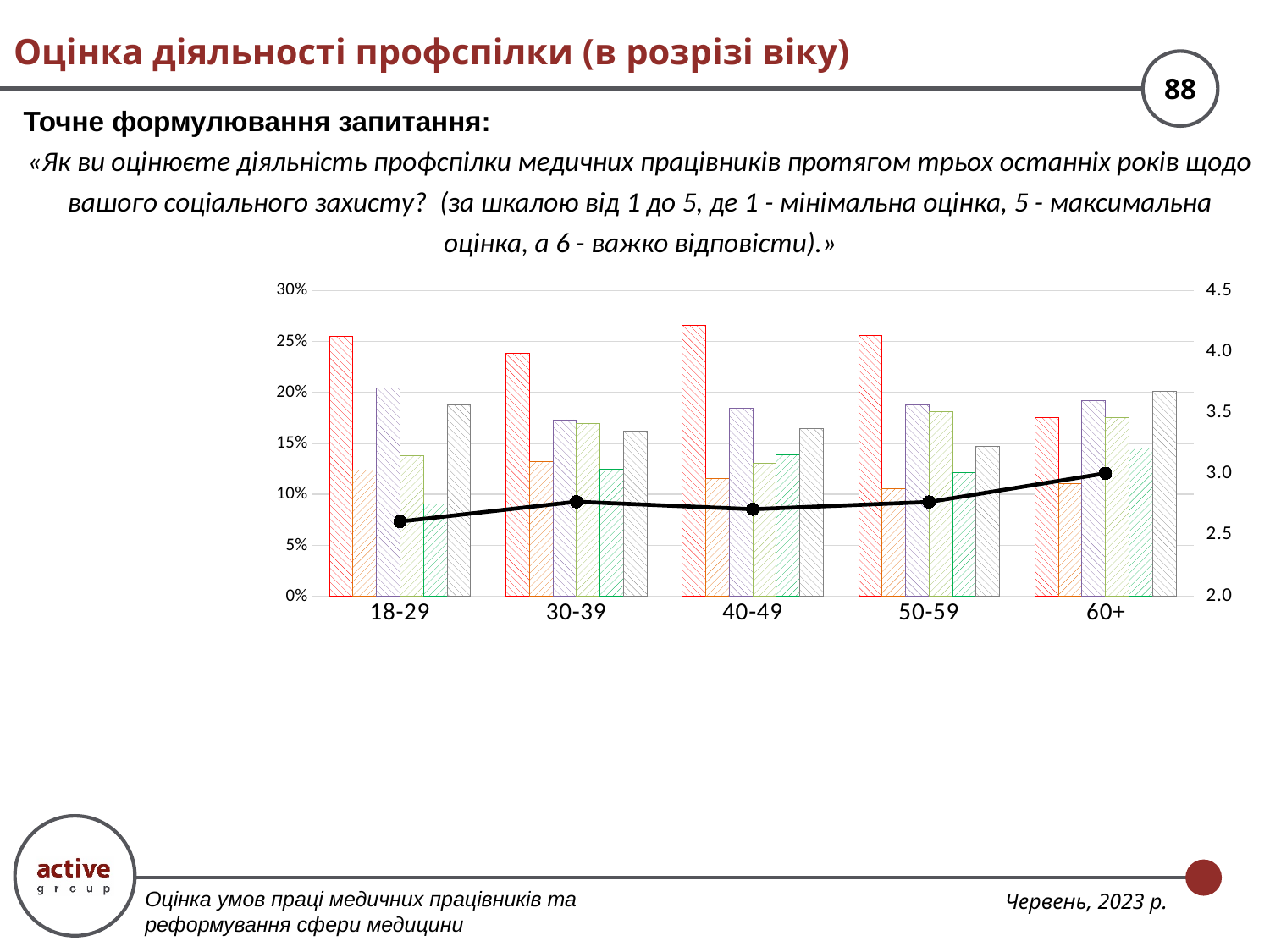
Is the line value for the 18-29 group greater or less than 3.0 on the right axis? less What is the maximum value shown on the right axis of the chart? 4.5 Which age group has the highest line value? 60+ Is the tallest bar in the 60+ group greater or less than 25%? less Is the line value for the 40-49 group greater or less than 3.0 on the right axis? less What kind of chart is shown on the slide? Combined bar and line chart What is the maximum value shown on the left (percentage) axis of the chart? 30% Does the line rise or fall overall from the 18-29 group to the 60+ group? rises How many age categories are shown on the x axis of the chart? 5 Which age group has the lowest line value? 18-29